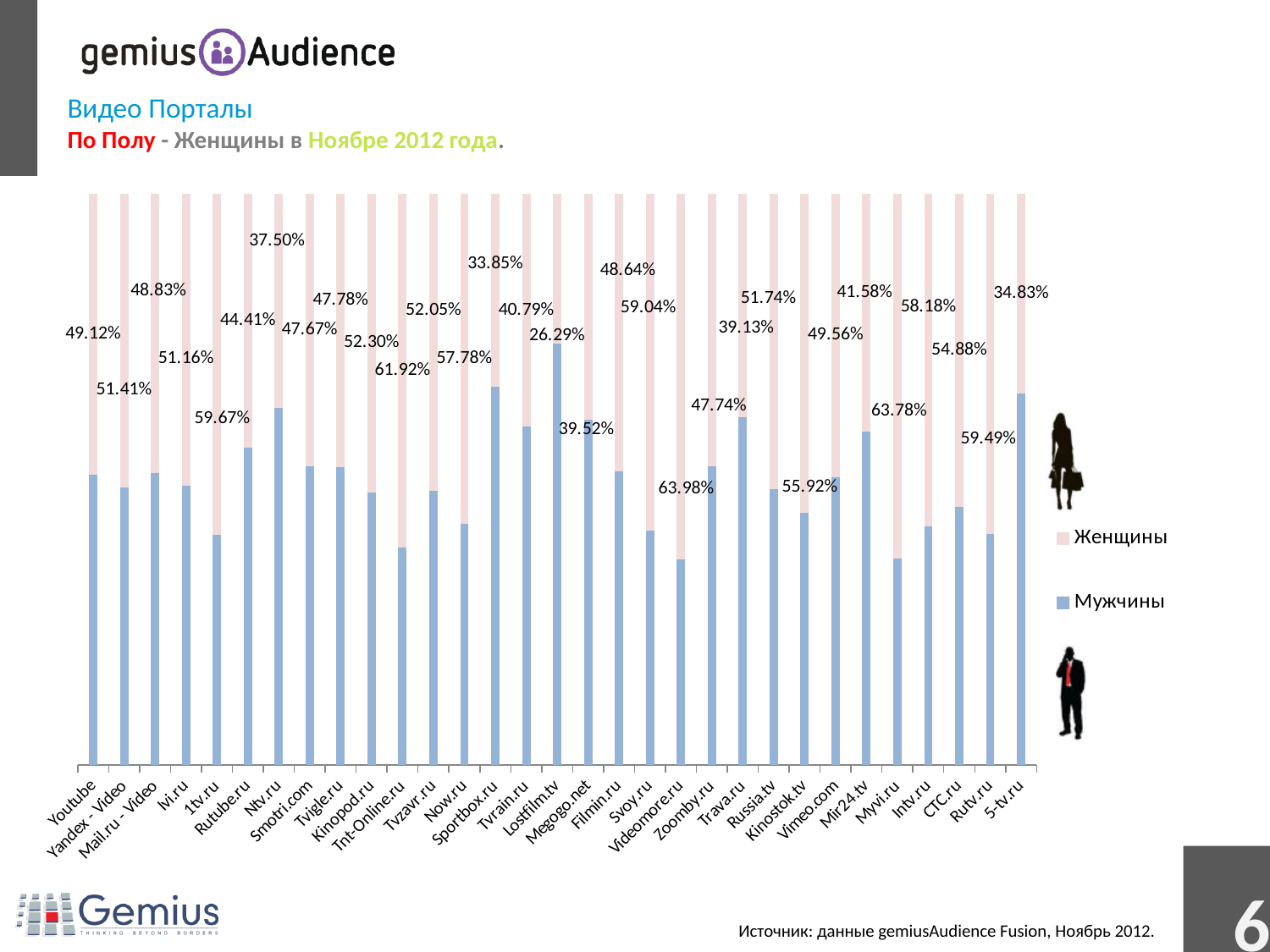
Which has a larger Женщины value, Videomore.ru or Trava.ru? Videomore.ru Which has a larger Женщины value, Ntv.ru or Sportbox.ru? Ntv.ru What is the difference between the Женщины values for Yandex - Video and Youtube? 2.29% Which series is shown in blue in the legend? Мужчины What is the Женщины value shown for 5-tv.ru? 34.83% What is the Женщины value shown for Youtube? 49.12% What is the Женщины value shown for Lostfilm.tv? 26.29% Which portal has the lowest Женщины value? Lostfilm.tv What kind of chart is shown on the slide? Stacked bar chart How many video portals are shown on the x axis? 31 How many series does the legend list? 2 What is the Женщины value shown for Tnt-Online.ru? 61.92%